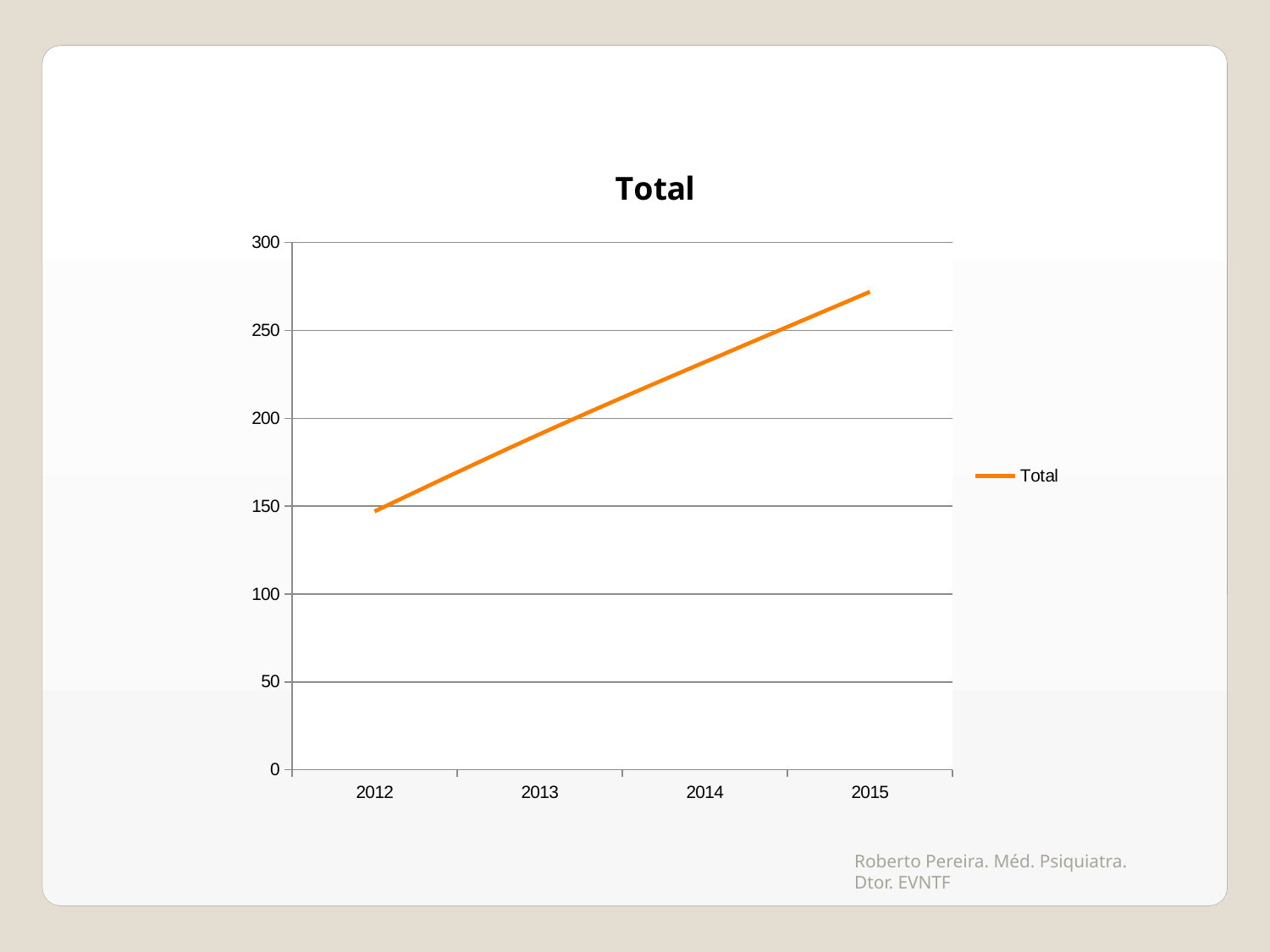
What kind of chart is shown on the slide? line chart Is the value for 2013 greater or less than 150? greater Which is larger, the value for 2013 or the value for 2015? 2015 Do the values rise or fall from 2012 to 2015? rise How many years are shown on the x axis? 4 Is the value for 2012 greater or less than 200? less How many series does the legend list? 1 Which year has the lowest value? 2012 What is the title of the chart? Total Is the value for 2015 greater or less than 250? greater Which year has the highest value? 2015